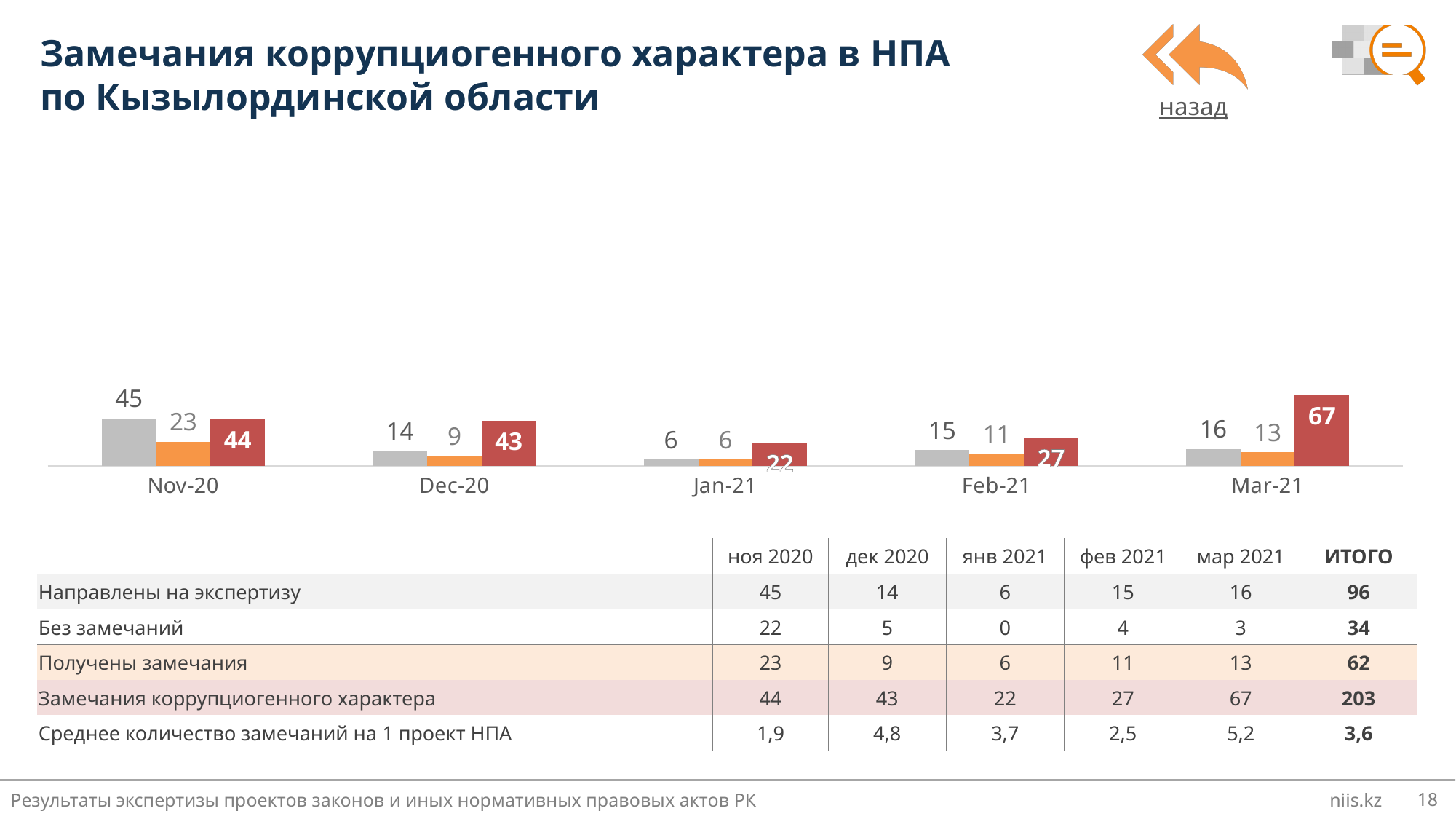
Which is larger for Dec-20: the grey bar or the red bar? the red bar What is the difference between the grey bar and the orange bar for Nov-20? 22 What is the value of the red bar for Mar-21? 67 What is the value of the grey bar for Nov-20? 45 What kind of chart is shown on the slide? bar chart In which month is the grey bar the lowest? Jan-21 Do the red bar values rise or fall from Feb-21 to Mar-21? rise What is the value of the orange bar for Feb-21? 11 How many bars are shown for each month in the chart? 3 How many months (categories) are shown on the x axis of the chart? 5 What is the difference between the red bar values for Mar-21 and Jan-21? 45 In which month is the red bar the highest? Mar-21